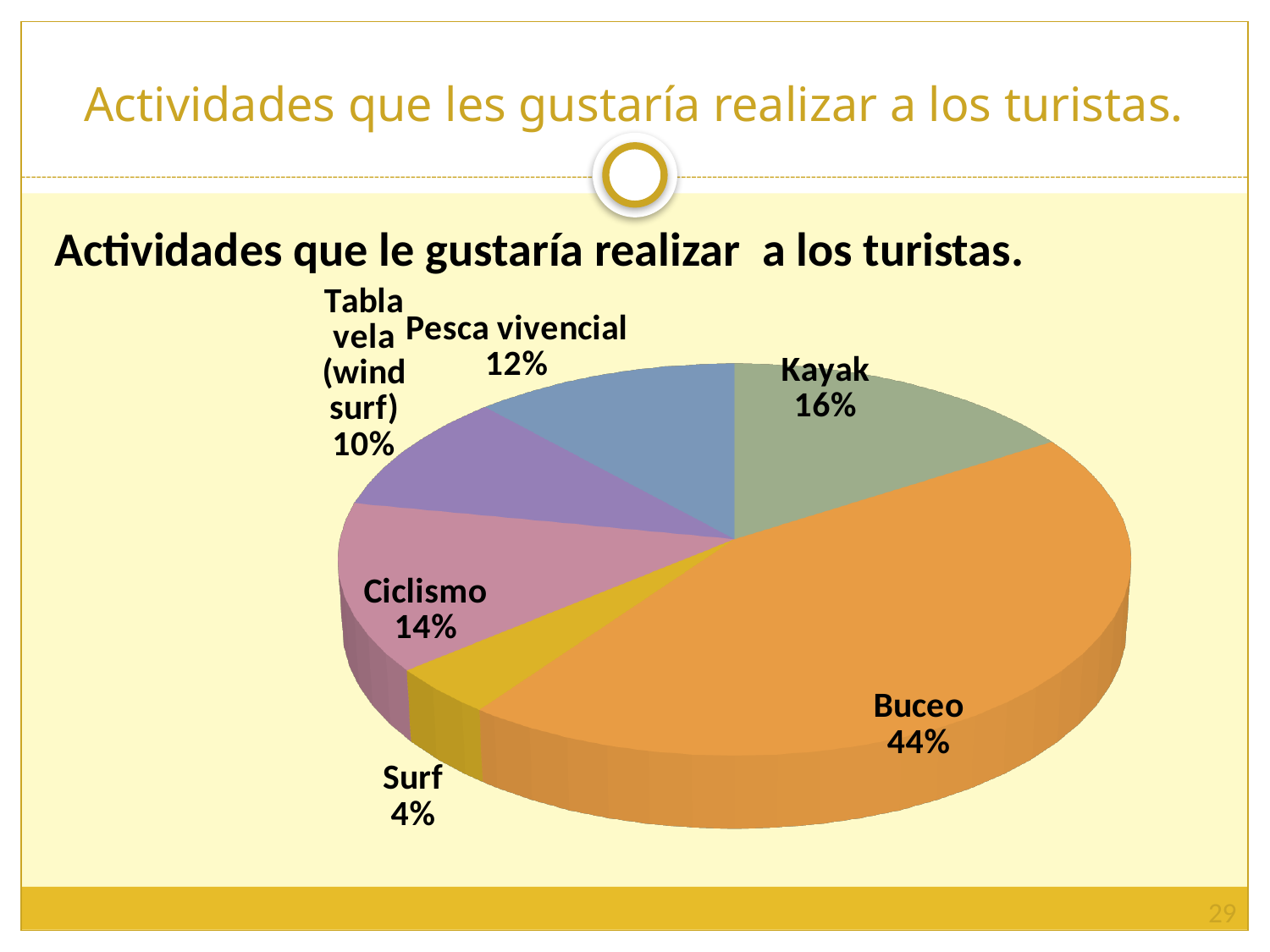
Which activity has the smallest slice of the pie? Surf What is the difference in percentage points between Buceo and Kayak? 28 What is the title of the chart? Actividades que le gustaría realizar a los turistas. Which activity has the largest slice of the pie? Buceo What is the value shown for Kayak? 16% What is the value shown for Ciclismo? 14% How many activities are shown in the pie chart? 6 Which is larger, Ciclismo or Pesca vivencial? Ciclismo What share of the pie does Buceo represent? 44% What is the value shown for Pesca vivencial? 12% What kind of chart is shown on the slide? Pie chart What is the value shown for Tabla vela (wind surf)? 10%